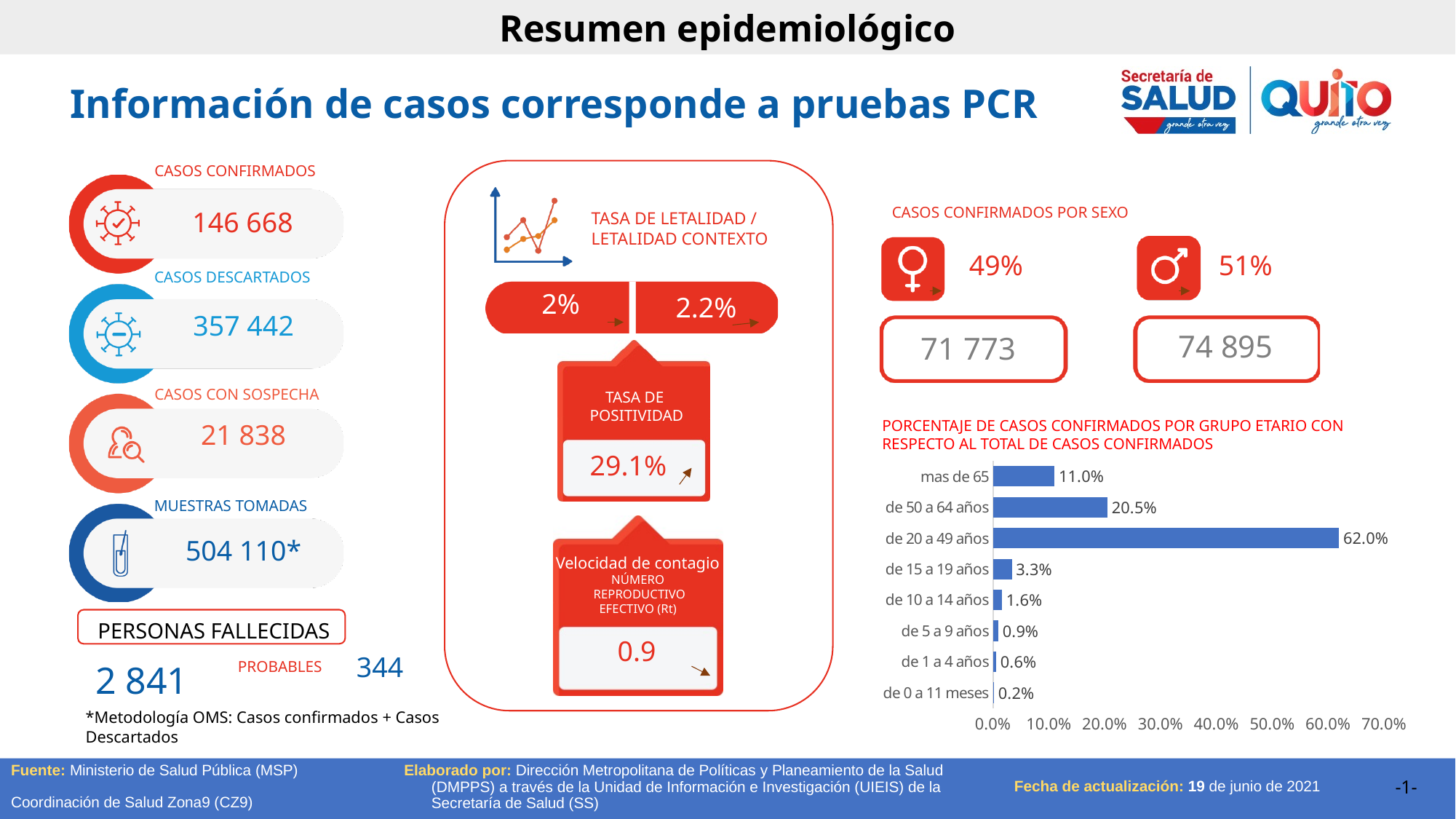
Which age group has the lowest percentage in the bar chart of confirmed cases by age group? de 0 a 11 meses How many age groups are shown in the bar chart of confirmed cases by age group? 8 What kind of chart is used to show the percentage of confirmed cases by age group? bar chart What is the value for 'de 50 a 64 años' in the bar chart of confirmed cases by age group? 20.5% What is the value for 'de 0 a 11 meses' in the bar chart of confirmed cases by age group? 0.2% In the bar chart of confirmed cases by age group, which is larger: 'de 15 a 19 años' or 'de 10 a 14 años'? de 15 a 19 años What is the value for 'de 20 a 49 años' in the bar chart of confirmed cases by age group? 62.0% In the bar chart of confirmed cases by age group, what is the difference between 'de 20 a 49 años' and 'de 50 a 64 años'? 41.5% What is the title of the chart showing confirmed cases by age group? PORCENTAJE DE CASOS CONFIRMADOS POR GRUPO ETARIO CON RESPECTO AL TOTAL DE CASOS CONFIRMADOS In the bar chart of confirmed cases by age group, is the value for 'de 20 a 49 años' greater or less than 50.0%? greater Which age group has the highest percentage in the bar chart of confirmed cases by age group? de 20 a 49 años What is the value for 'mas de 65' in the bar chart of confirmed cases by age group? 11.0%